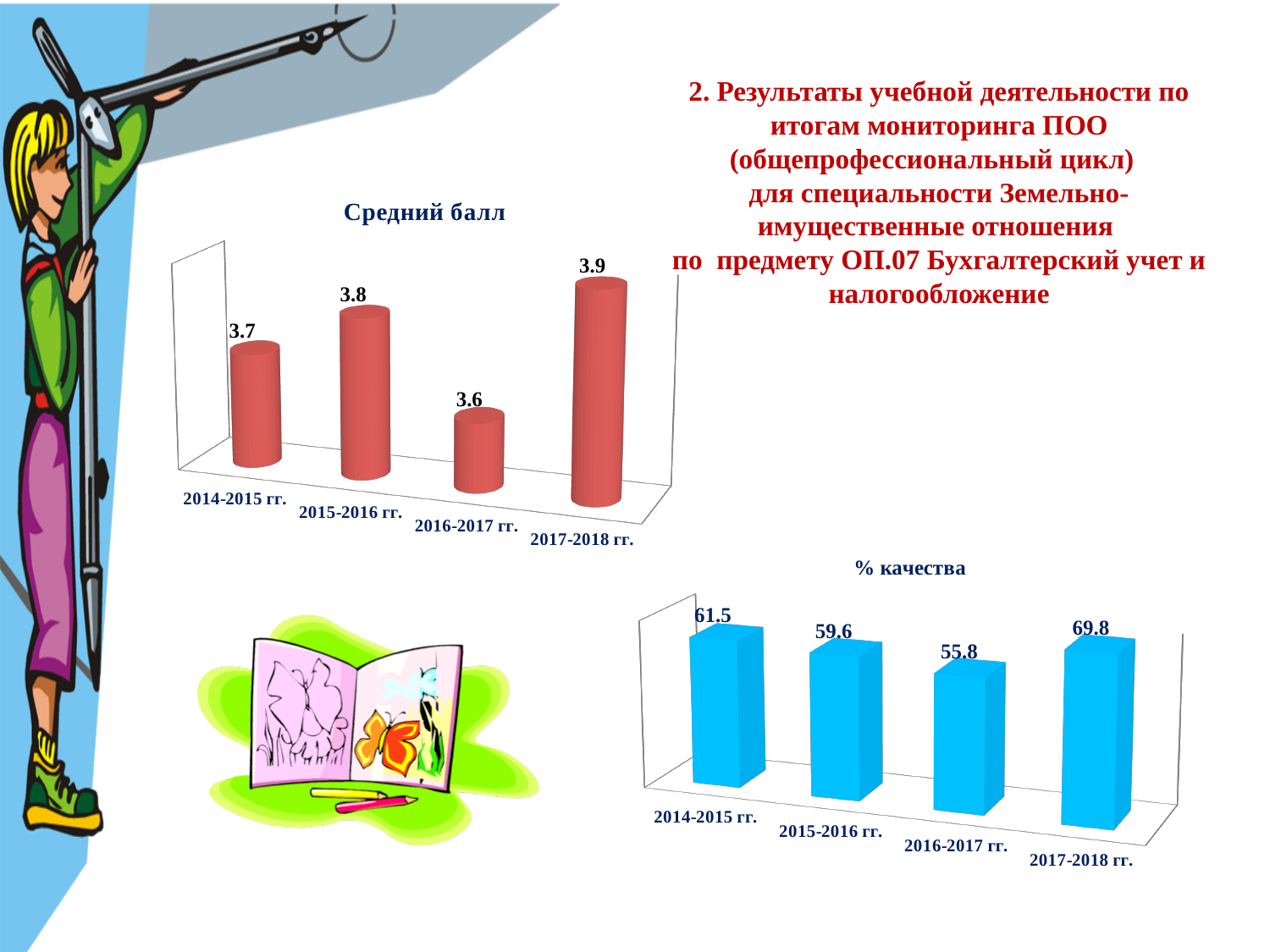
In the "% качества" chart, which year has the lowest value? 2016-2017 гг. In the "Средний балл" chart, what is the difference between the values for 2017-2018 гг. and 2016-2017 гг.? 0.3 In the "% качества" chart, what is the value for 2017-2018 гг.? 69.8 In the "Средний балл" chart, what is the value for 2014-2015 гг.? 3.7 What kind of chart is the "% качества" chart? Bar chart In the "Средний балл" chart, which year has the highest value? 2017-2018 гг. In the "Средний балл" chart, which year has the lowest value? 2016-2017 гг. In the "% качества" chart, which is larger, the value for 2014-2015 гг. or 2015-2016 гг.? 2014-2015 гг. What is the title of the upper chart on the slide? Средний балл In the "% качества" chart, what is the difference between the values for 2017-2018 гг. and 2014-2015 гг.? 8.3 In the "Средний балл" chart, how many categories are shown? 4 In the "% качества" chart, what is the value for 2015-2016 гг.? 59.6